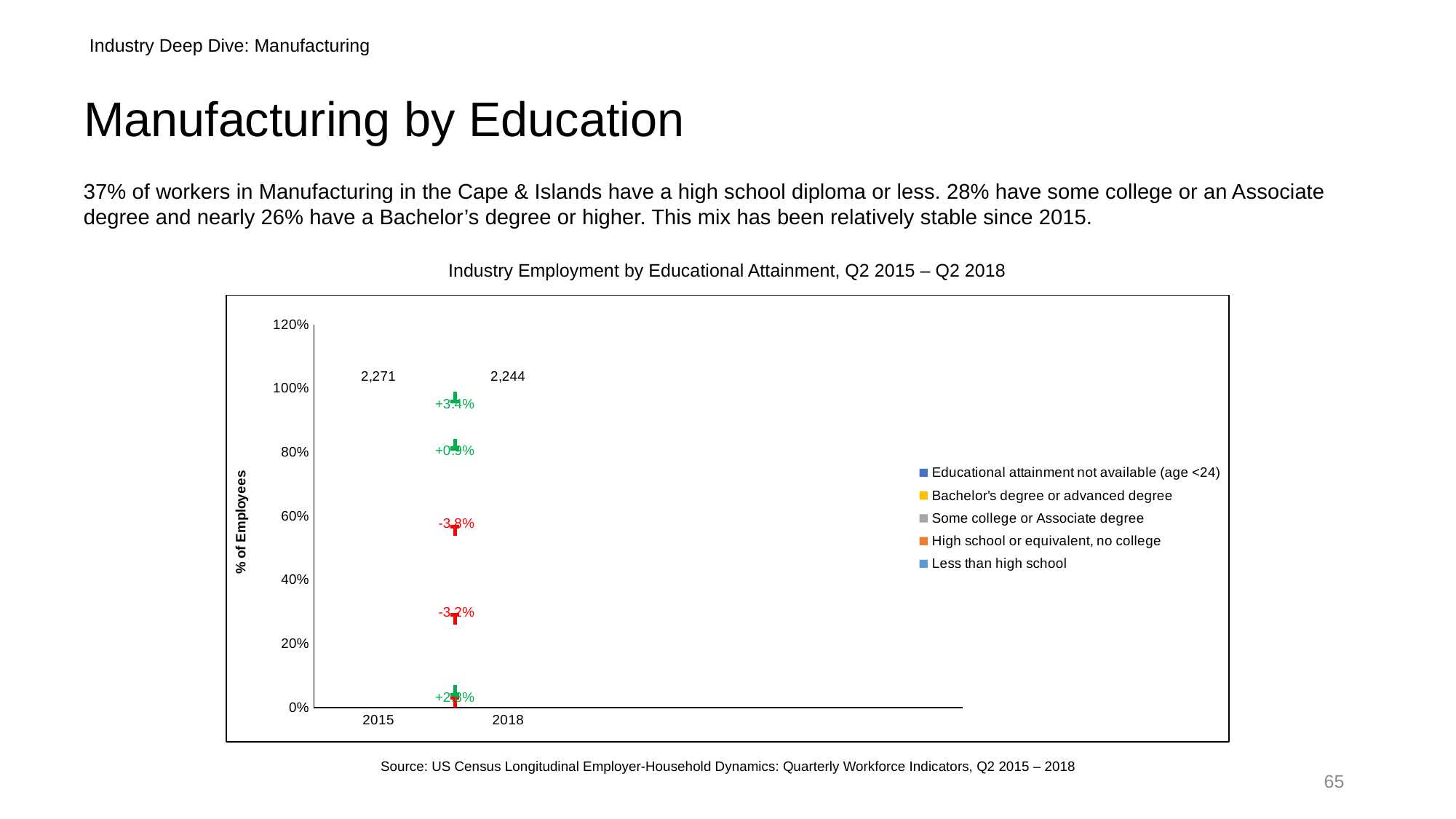
What is the difference between the labelled totals for 2015 (2,271) and 2018 (2,244)? 27 Which year has the larger labelled total employment, 2015 or 2018? 2015 How many years are shown on the x axis of the chart? 2 What is the first series listed in the chart's legend? Educational attainment not available (age <24) What total employment figure is labelled above the 2015 column in the chart? 2,271 How many series does the chart's legend list? 5 What is the last series listed in the chart's legend? Less than high school What total employment figure is labelled above the 2018 column in the chart? 2,244 What is the title of the chart? Industry Employment by Educational Attainment, Q2 2015 – Q2 2018 What is the highest value shown on the y axis of the chart? 120%